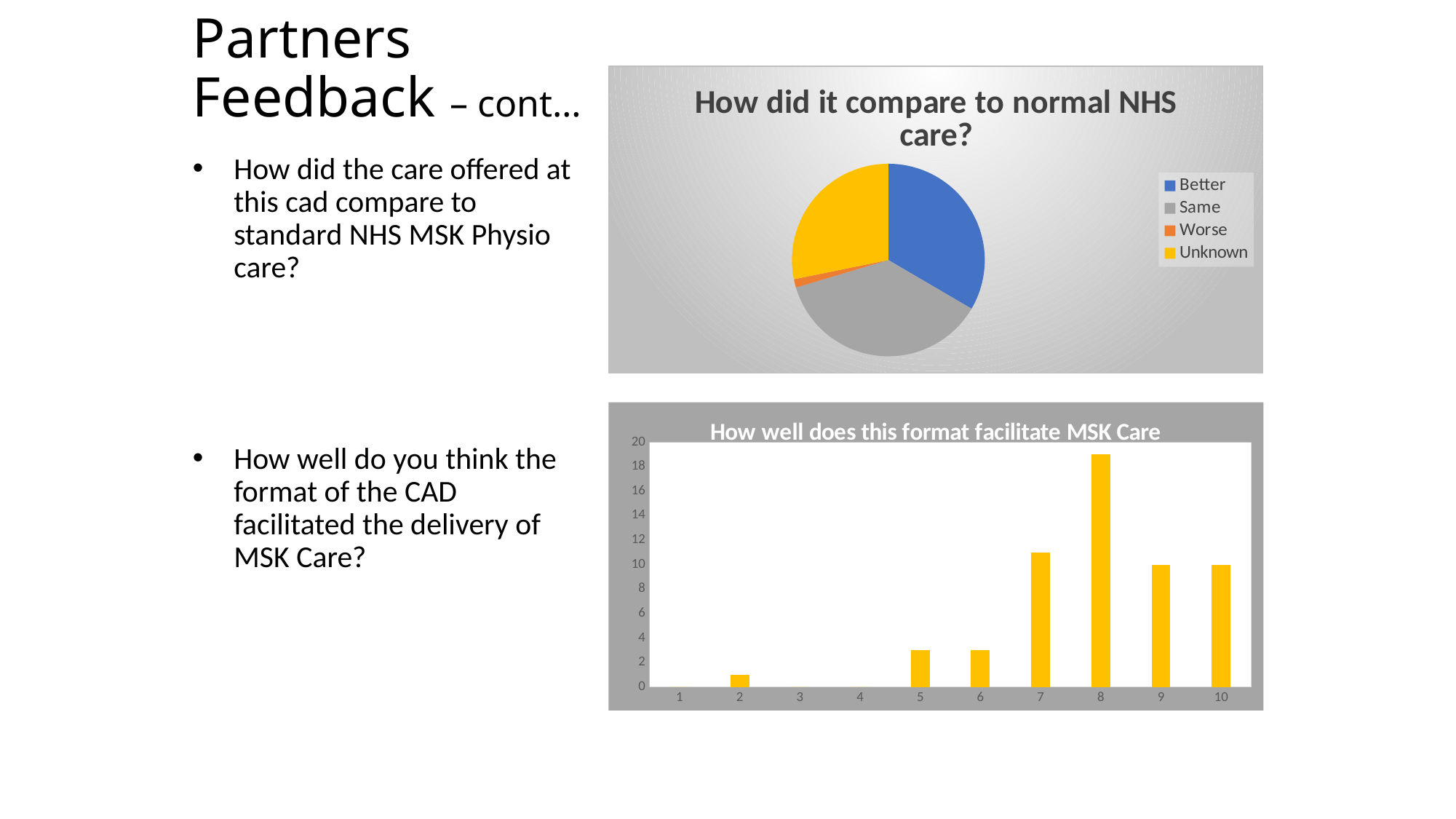
What kind of chart is the top chart titled "How did it compare to normal NHS care?"? pie chart What kind of chart is the bottom chart titled "How well does this format facilitate MSK Care"? bar chart How many entries does the legend of the pie chart "How did it compare to normal NHS care?" list? 4 In the pie chart "How did it compare to normal NHS care?", which category has the smallest slice? Worse In the bar chart "How well does this format facilitate MSK Care", is the value for category 2 greater or less than 2? less In the pie chart "How did it compare to normal NHS care?", which slice is larger, Better or Worse? Better In the bar chart "How well does this format facilitate MSK Care", is the value for category 7 greater or less than 10? greater How many categories are shown on the x axis of the bar chart "How well does this format facilitate MSK Care"? 10 In the bar chart "How well does this format facilitate MSK Care", which category has the tallest bar? 8 In the bar chart "How well does this format facilitate MSK Care", is the value for category 8 greater or less than 18? greater In the pie chart "How did it compare to normal NHS care?", what colour is the Unknown slice? yellow In the bar chart "How well does this format facilitate MSK Care", which is larger, the value for category 7 or the value for category 5? 7